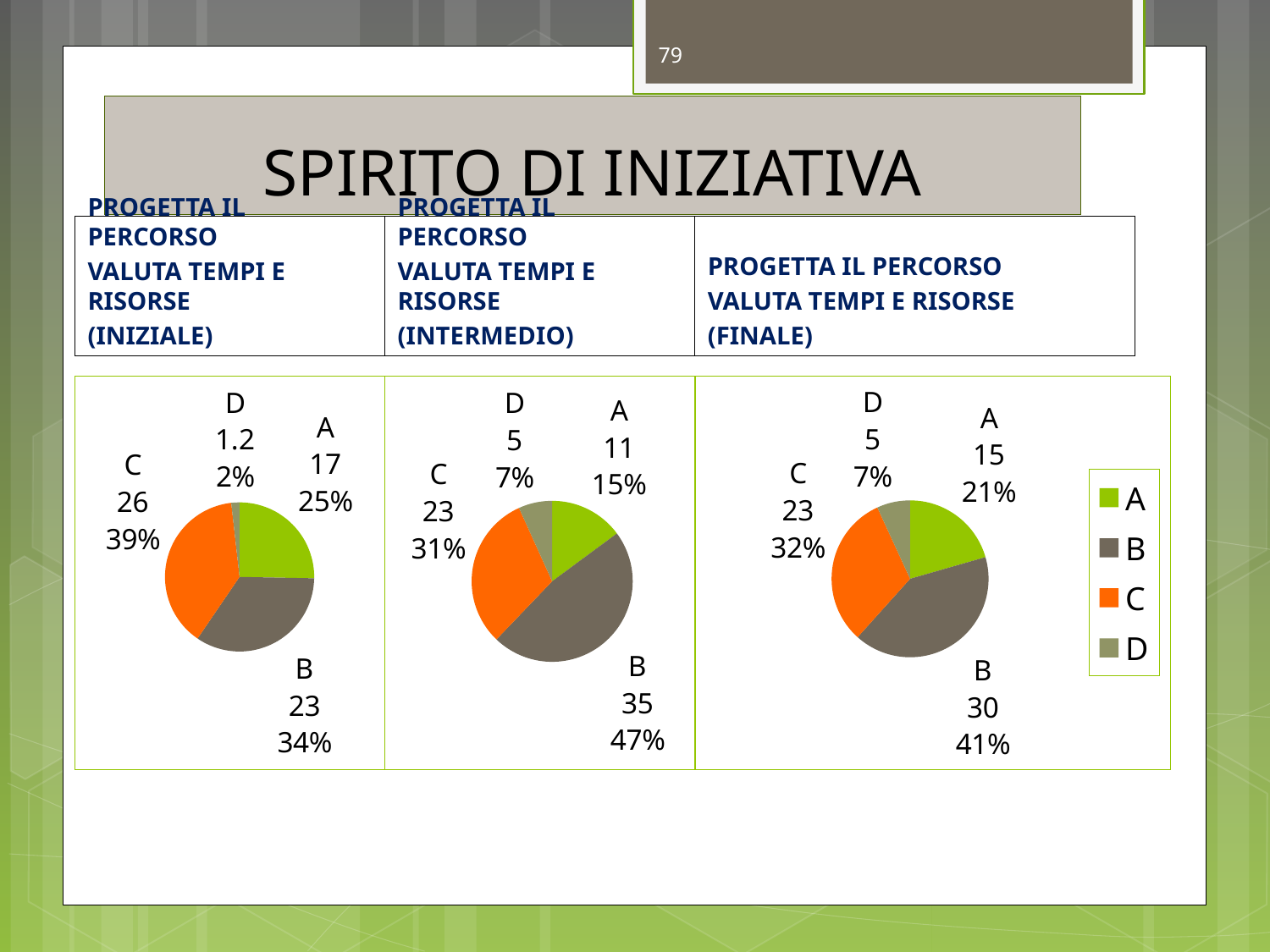
In the middle pie chart (INTERMEDIO), which category has the largest slice? B In the right pie chart (FINALE), which category has the smallest slice? D In the left pie chart (INIZIALE), what percentage share does category D have? 2% In the right pie chart (FINALE), what is the difference between the values for B and C? 7 What kind of chart is used on this slide? Pie chart In the middle pie chart (INTERMEDIO), what value is shown for category B? 35 In the middle pie chart (INTERMEDIO), which is larger, the value for A or the value for C? C How many categories does each pie chart show? 4 How many entries does the legend on the right list? 4 In the left pie chart (INIZIALE), which category has the largest slice? C In the left pie chart (INIZIALE), what value is shown for category C? 26 In the right pie chart (FINALE), what percentage share does category A have? 21%